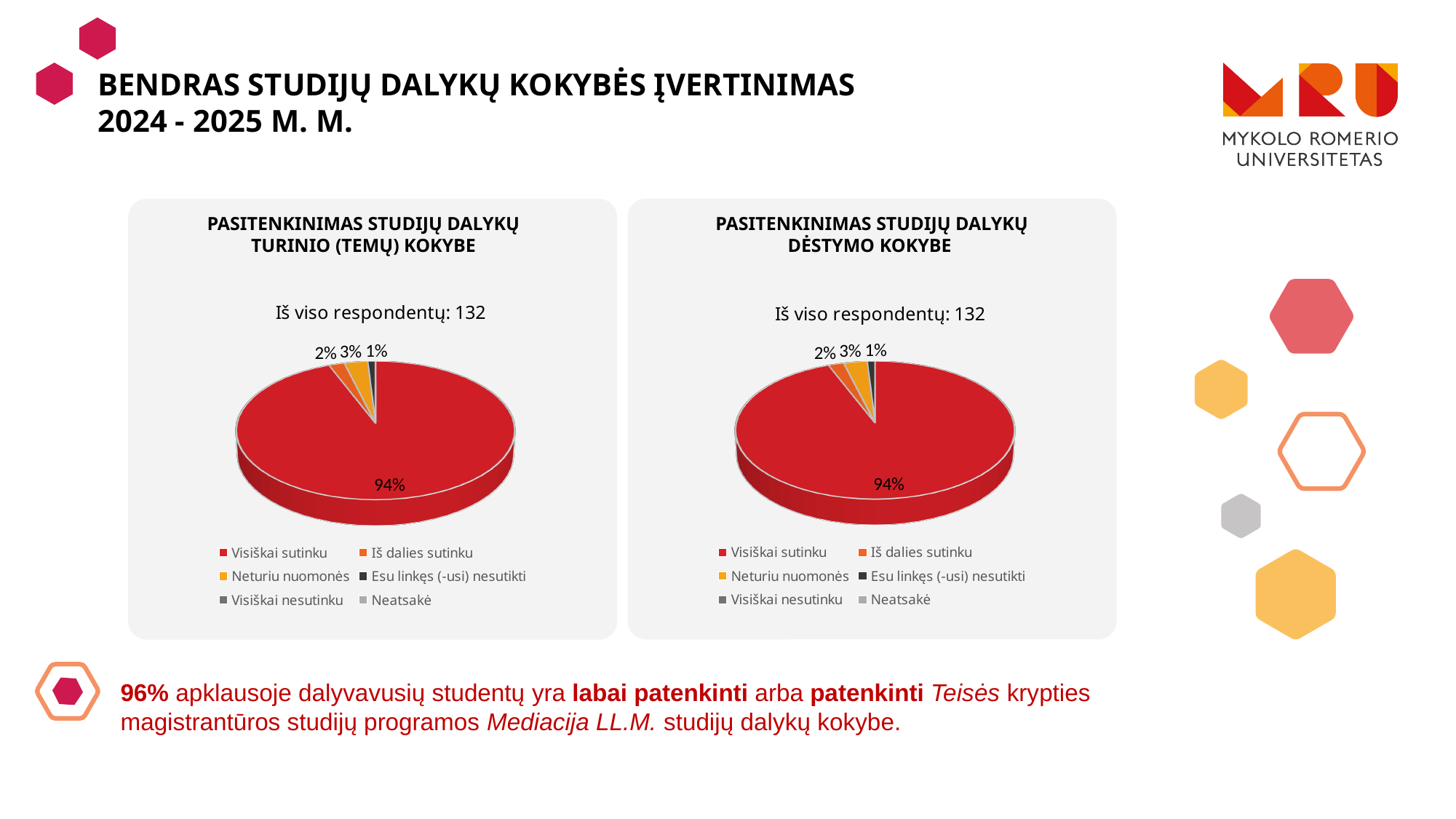
How many respondents are reported for the left chart (Pasitenkinimas studijų dalykų turinio (temų) kokybe)? 132 In the left chart (Pasitenkinimas studijų dalykų turinio (temų) kokybe), what is the difference between the 'Visiškai sutinku' share and the 'Neturiu nuomonės' share? 91% In the right chart (Pasitenkinimas studijų dalykų dėstymo kokybe), what share is shown for 'Esu linkęs (-usi) nesutikti'? 1% In the left chart (Pasitenkinimas studijų dalykų turinio (temų) kokybe), what share of respondents chose 'Visiškai sutinku'? 94% In the right chart (Pasitenkinimas studijų dalykų dėstymo kokybe), what share is shown for 'Iš dalies sutinku'? 2% How many entries does the legend of the right chart (Pasitenkinimas studijų dalykų dėstymo kokybe) list? 6 In the left chart (Pasitenkinimas studijų dalykų turinio (temų) kokybe), which is larger: 'Iš dalies sutinku' or 'Neturiu nuomonės'? Neturiu nuomonės What kind of chart is used on the left (Pasitenkinimas studijų dalykų turinio (temų) kokybe)? Pie chart In the left chart (Pasitenkinimas studijų dalykų turinio (temų) kokybe), which category has the largest slice? Visiškai sutinku In the right chart (Pasitenkinimas studijų dalykų dėstymo kokybe), which labelled category has the smallest slice? Esu linkęs (-usi) nesutikti